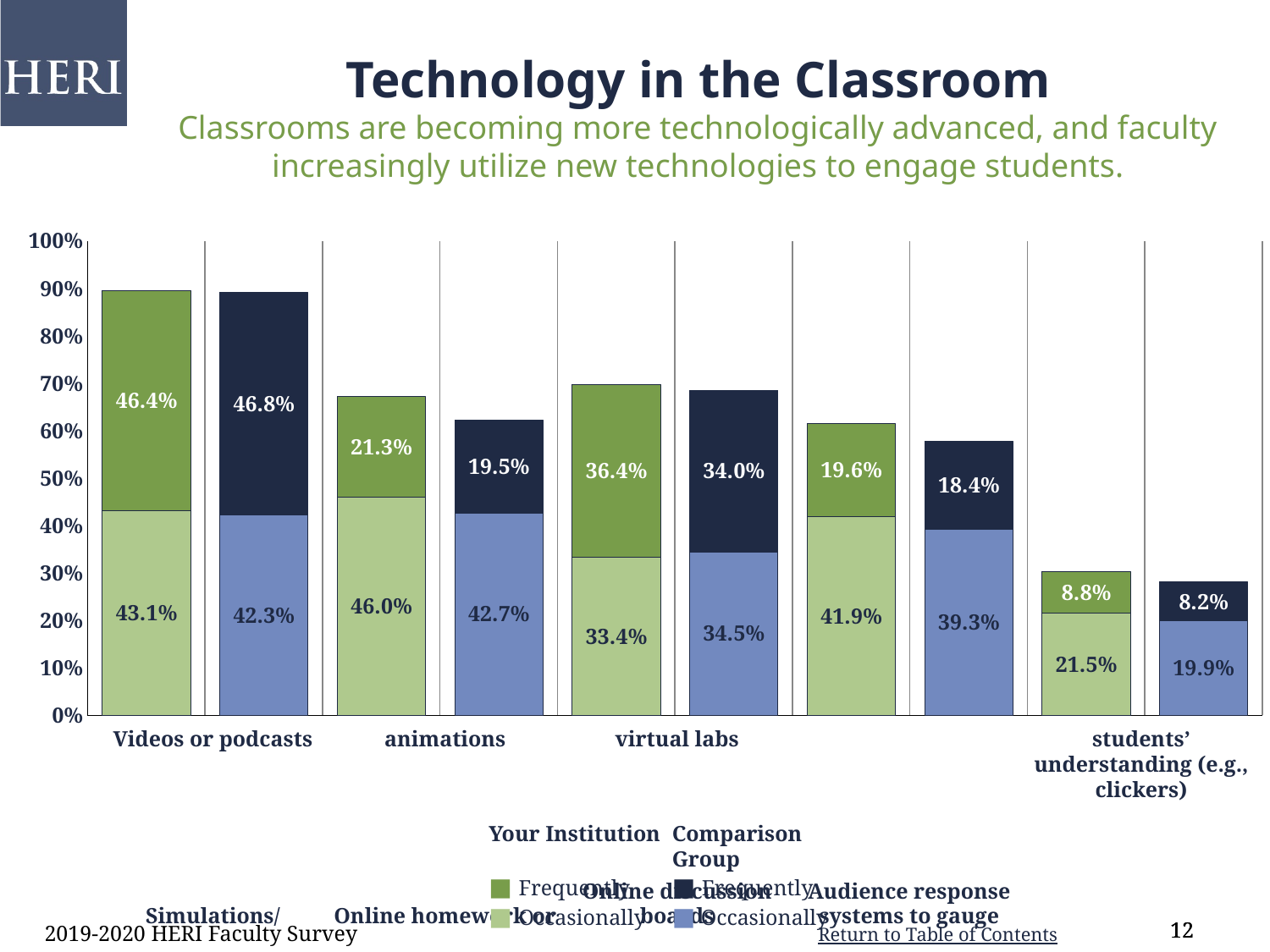
How many groups of bars are shown in the chart? 5 In the last group of bars (students' understanding, e.g., clickers), which has the larger 'Occasionally' value: Your Institution or the Comparison Group? Your Institution What is the difference between the Comparison Group's and Your Institution's 'Frequently' values in the 'Videos or podcasts' group? 0.4 percentage points What is the total height of the Your Institution bar in the 'Videos or podcasts' group (Frequently plus Occasionally)? 89.5% What is the 'Frequently' value for Your Institution in the 'Videos or podcasts' group? 46.4% What type of chart is shown on the slide? Stacked bar chart What is the 'Occasionally' value for the Comparison Group in the last group of bars (students' understanding, e.g., clickers)? 19.9% Which group of bars has the highest 'Frequently' value for Your Institution? Videos or podcasts What is the 'Occasionally' value for the Comparison Group in the 'Videos or podcasts' group? 42.3% Which group of bars has the lowest 'Occasionally' value for the Comparison Group? The last group (students' understanding, e.g., clickers) Is the total height of the Your Institution bar in the 'Videos or podcasts' group greater or less than 80%? greater What is the 'Frequently' value for Your Institution in the last group of bars (students' understanding, e.g., clickers)? 8.8%